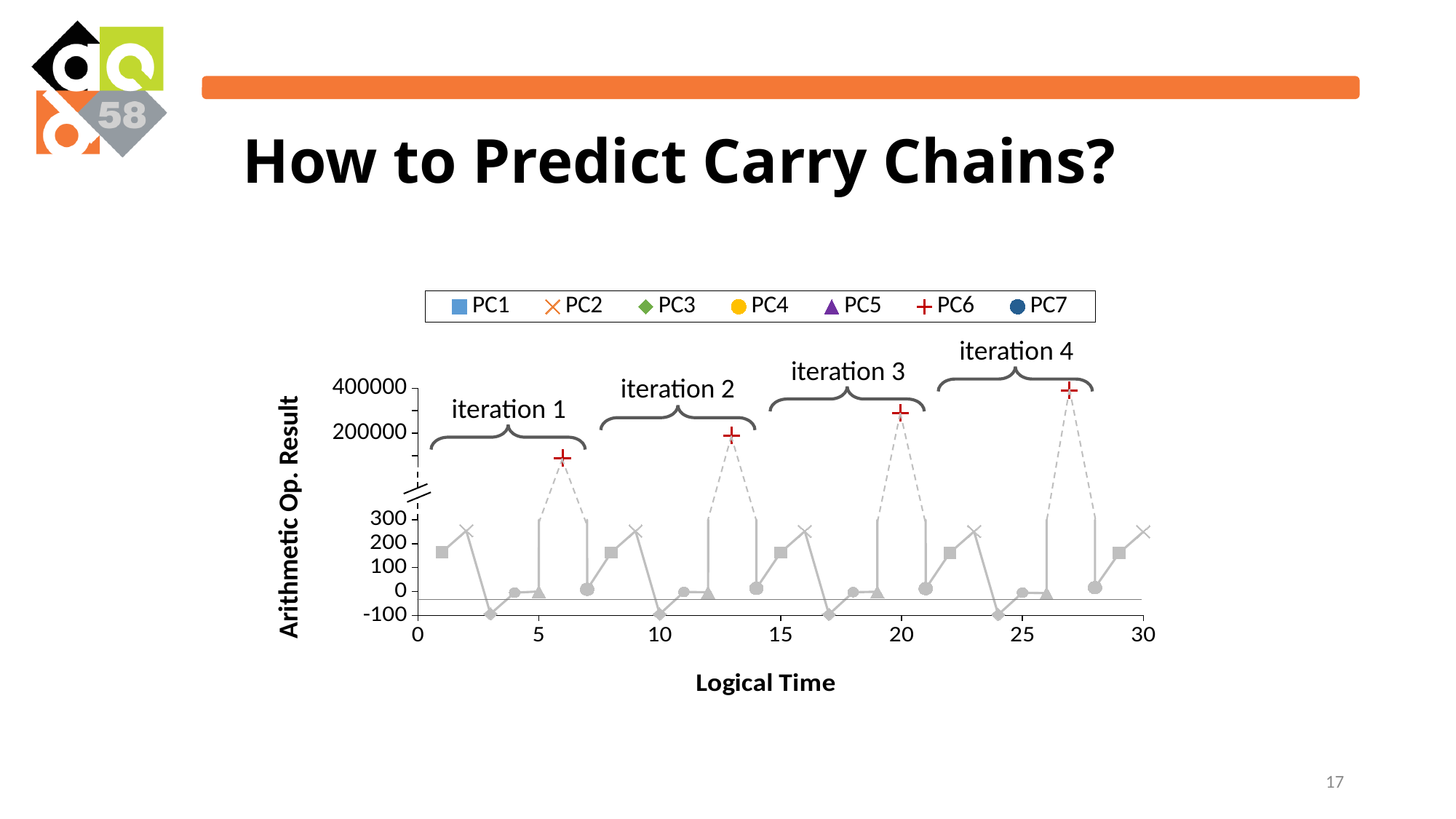
Which is larger, the PC6 value in iteration 4 or the PC6 value in iteration 1? iteration 4 Do the PC6 values rise or fall from iteration 1 to iteration 4? rise Is the PC6 value in iteration 1 greater or less than 200000? less How many series does the legend list? 7 What is the title of the x axis? Logical Time Is the PC6 value in iteration 4 greater or less than 200000? greater Which series reaches the highest values on the chart? PC6 Is the PC3 value at logical time 3 greater or less than 0? less What kind of chart is shown on the slide? line chart How many iterations are marked with braces above the chart? 4 What is the title of the y axis? Arithmetic Op. Result